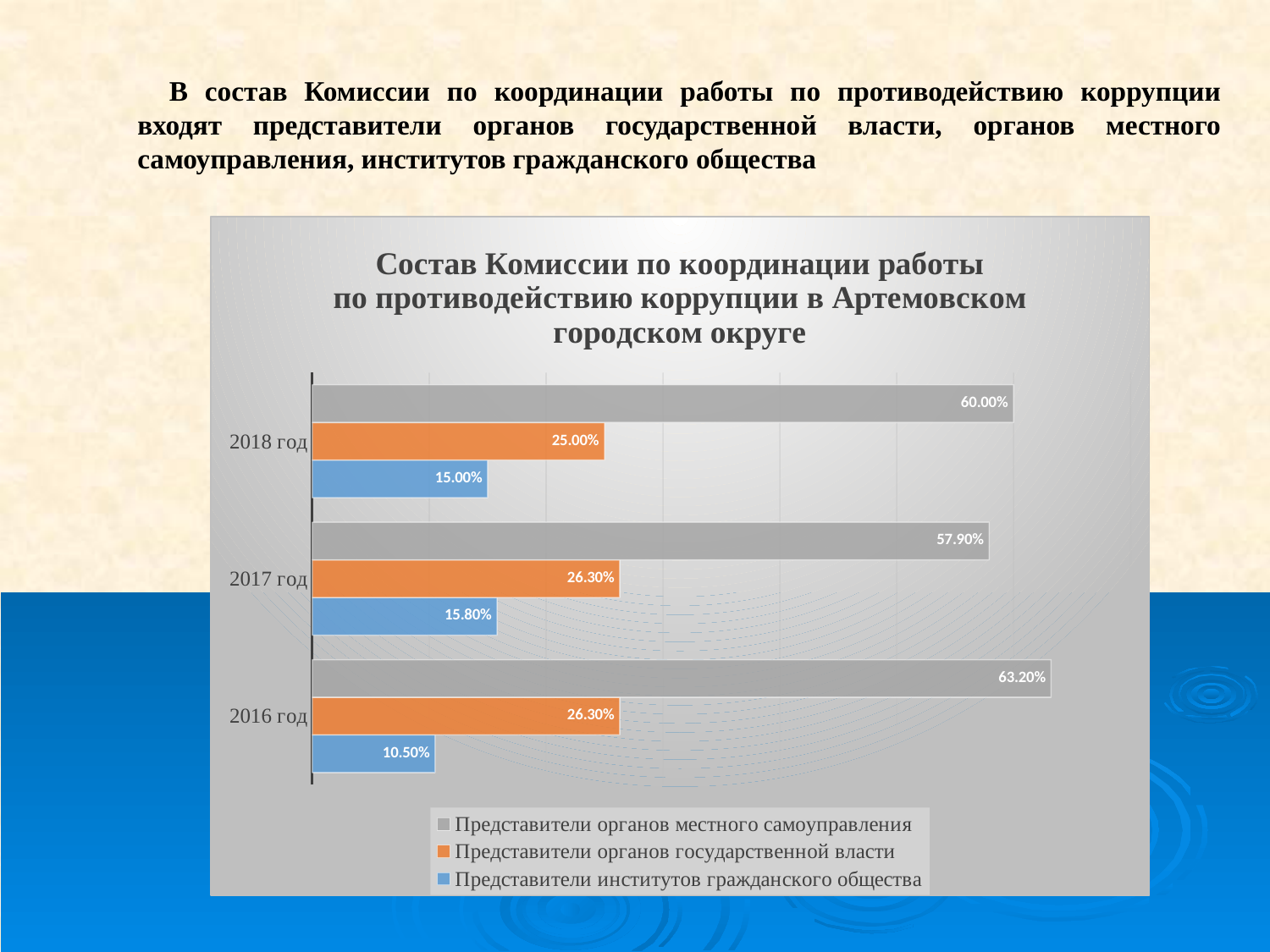
What type of chart is shown on the slide? bar chart How many year categories are shown on the chart? 3 What is the difference between the values for Представители органов местного самоуправления in 2016 год and 2018 год? 3.20% Which is larger in 2018 год: Представители органов государственной власти or Представители институтов гражданского общества? Представители органов государственной власти What is the value for Представители органов государственной власти in 2017 год? 26.30% Does the value for Представители институтов гражданского общества rise or fall from 2017 год to 2018 год? fall How many series does the legend list? 3 In which year is the value for Представители органов местного самоуправления highest? 2016 год What is the value for Представители институтов гражданского общества in 2016 год? 10.50% Which colour represents Представители органов государственной власти in the legend? orange What is the value for Представители органов местного самоуправления in 2018 год? 60.00% In which year is the value for Представители институтов гражданского общества lowest? 2016 год